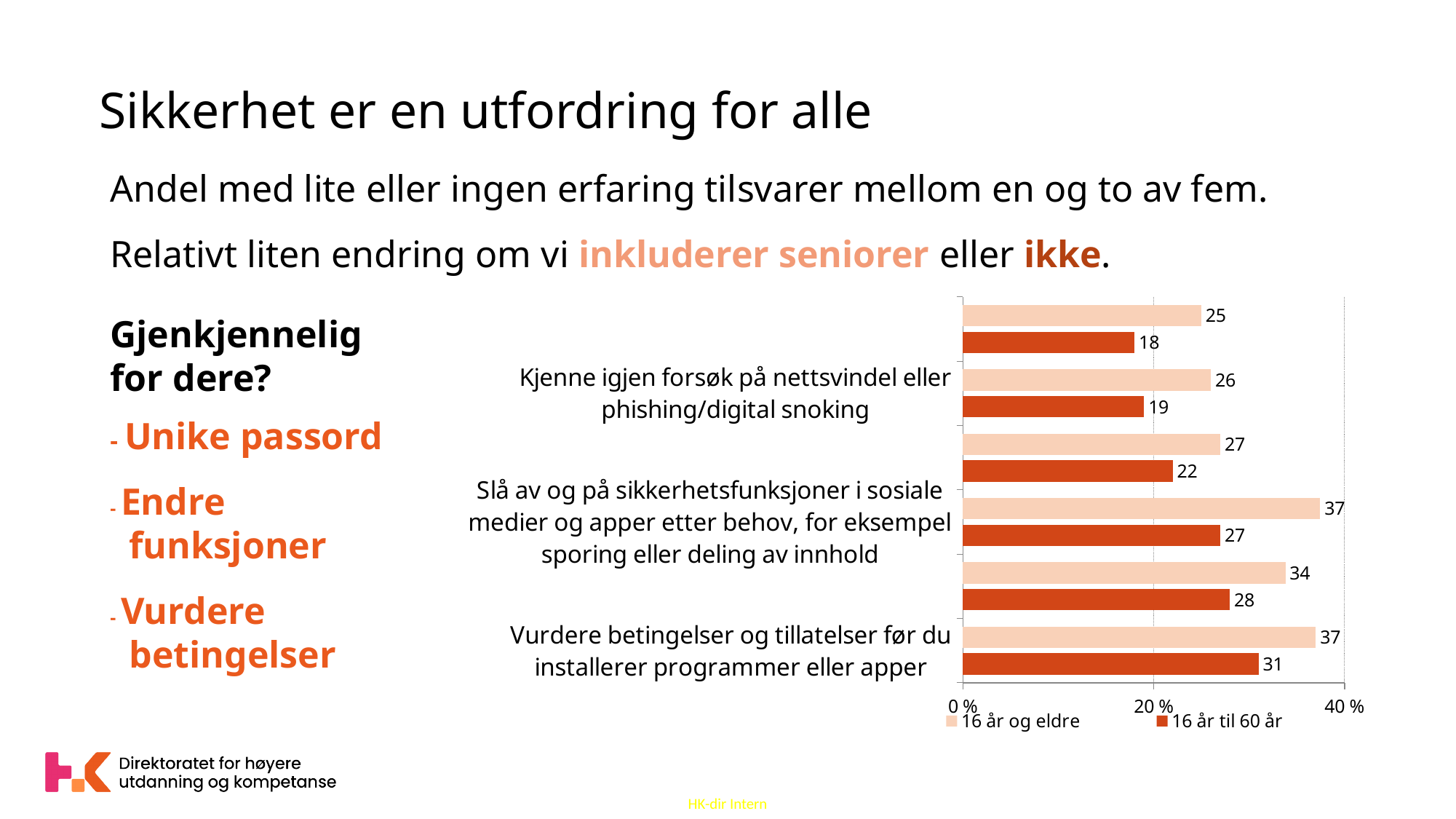
What are the two series named in the chart legend? 16 år og eldre; 16 år til 60 år What is the difference between the '16 år og eldre' and '16 år til 60 år' values for 'Slå av og på sikkerhetsfunksjoner i sosiale medier og apper etter behov'? 10 What is the value for '16 år til 60 år' for 'Kjenne igjen forsøk på nettsvindel eller phishing/digital snoking'? 19 What is the value for '16 år og eldre' for 'Kjenne igjen forsøk på nettsvindel eller phishing/digital snoking'? 26 What is the difference between the '16 år og eldre' and '16 år til 60 år' values for 'Vurdere betingelser og tillatelser før du installerer programmer eller apper'? 6 Is the '16 år til 60 år' value for 'Vurdere betingelser og tillatelser før du installerer programmer eller apper' greater or less than 20 %? greater What is the value for '16 år og eldre' for 'Slå av og på sikkerhetsfunksjoner i sosiale medier og apper etter behov'? 37 What is the value for '16 år til 60 år' for 'Vurdere betingelser og tillatelser før du installerer programmer eller apper'? 31 What kind of chart is shown on the slide? bar chart What is the lowest value shown in the '16 år til 60 år' series? 18 How many series does the chart legend list? 2 Which series has the larger value for 'Kjenne igjen forsøk på nettsvindel eller phishing/digital snoking'? 16 år og eldre